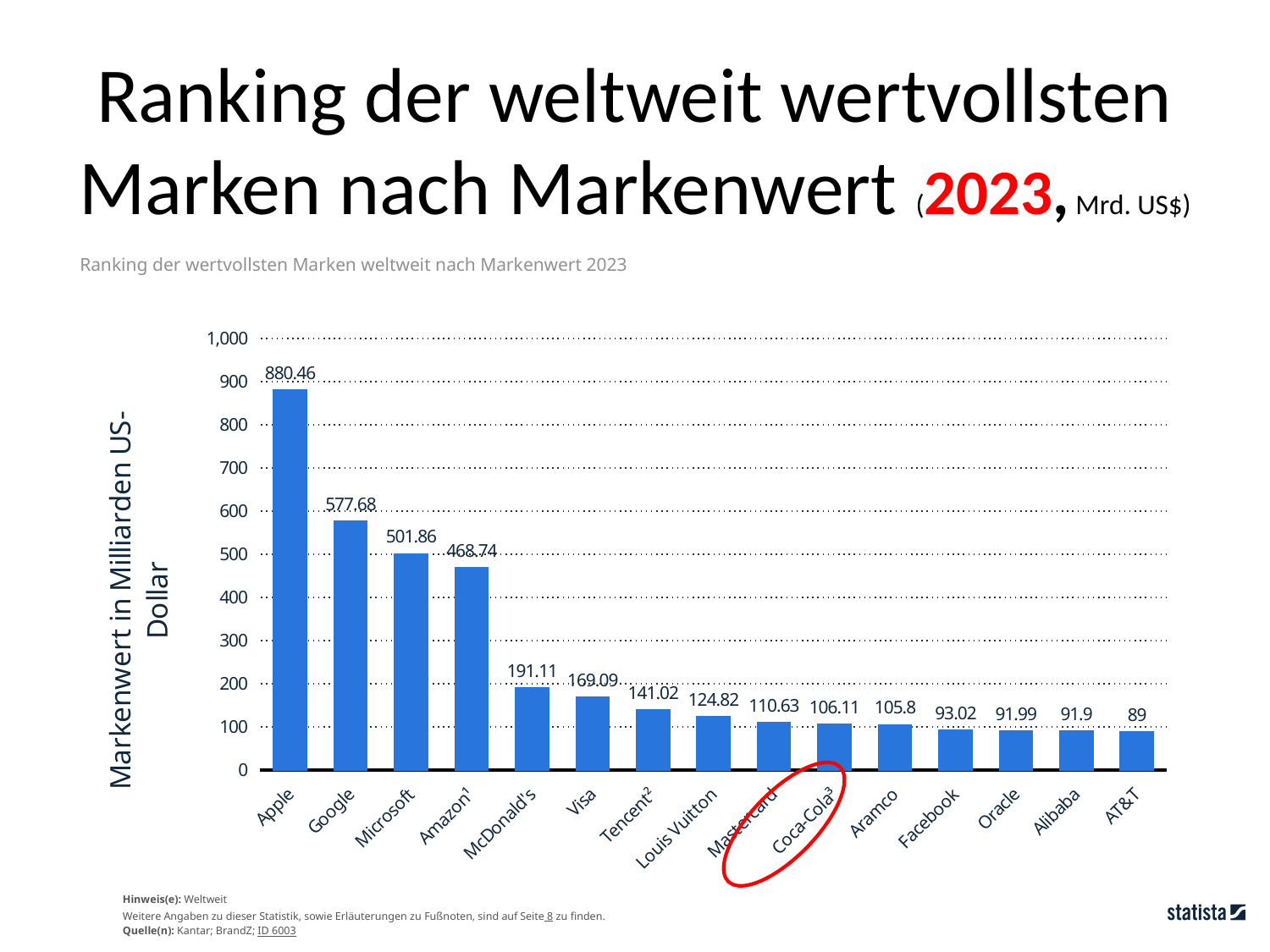
Which brand has the highest brand value in the chart? Apple What kind of chart is shown on the slide? Bar chart Is the value for Tencent greater or less than 200? less What is the brand value shown for Coca-Cola? 106.11 What is the label of the y axis? Markenwert in Milliarden US-Dollar Which brand has the lowest brand value in the chart? AT&T Which has a higher brand value, Amazon or McDonald's? Amazon What is the brand value shown for Visa? 169.09 Do the brand values rise or fall from left to right along the x axis? Fall What is the difference between the brand values of Google and Microsoft? 75.82 How many brands are shown in the chart? 15 What is the brand value shown for Apple? 880.46